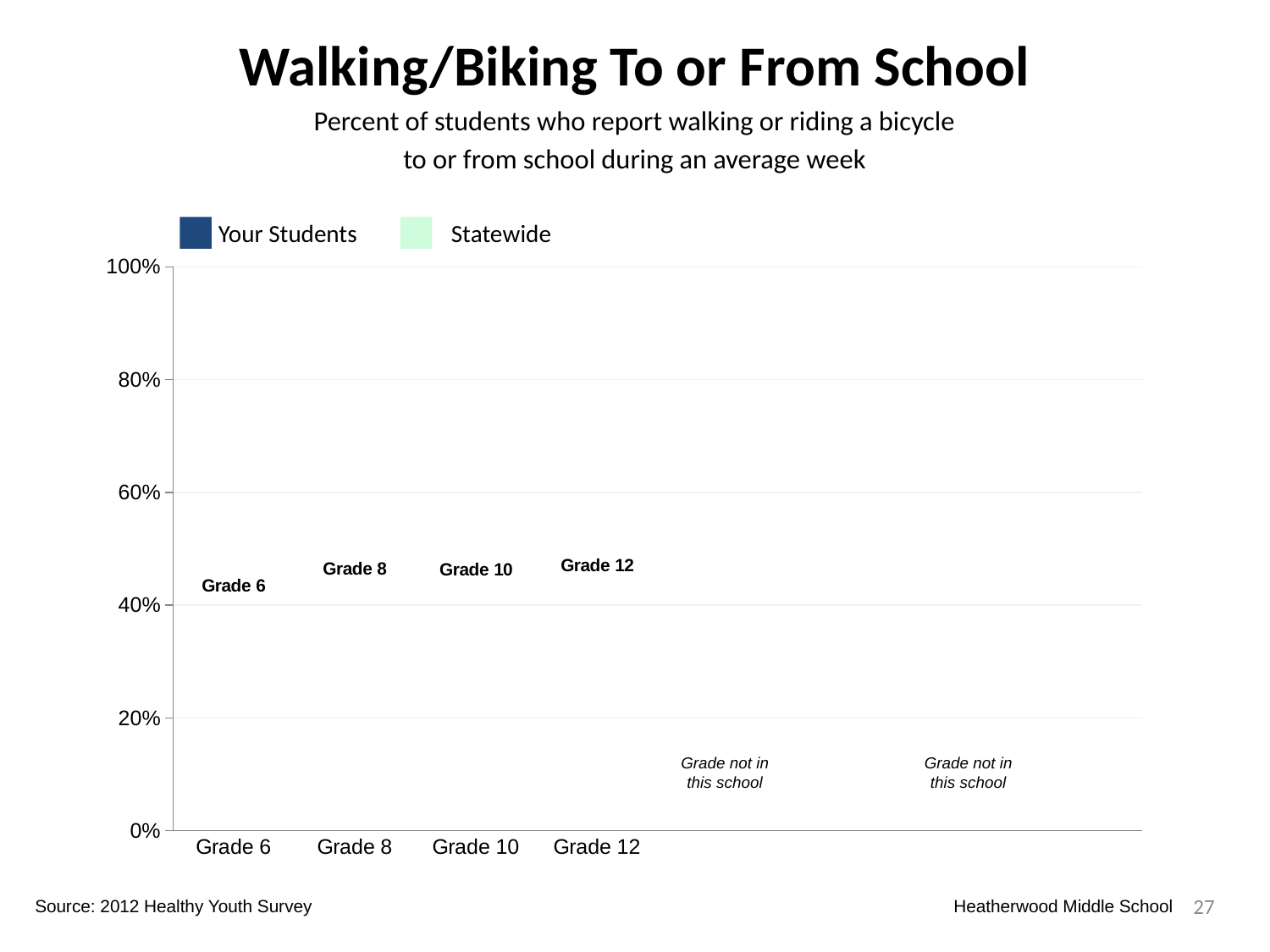
What is the title of the chart? Walking/Biking To or From School Which grade categories are labelled on the x axis? Grade 6, Grade 8, Grade 10, Grade 12 What are the two series named in the legend? Your Students and Statewide How many grade categories are labelled on the x axis? 4 What is the highest value shown on the y axis? 100% How many series does the legend list? 2